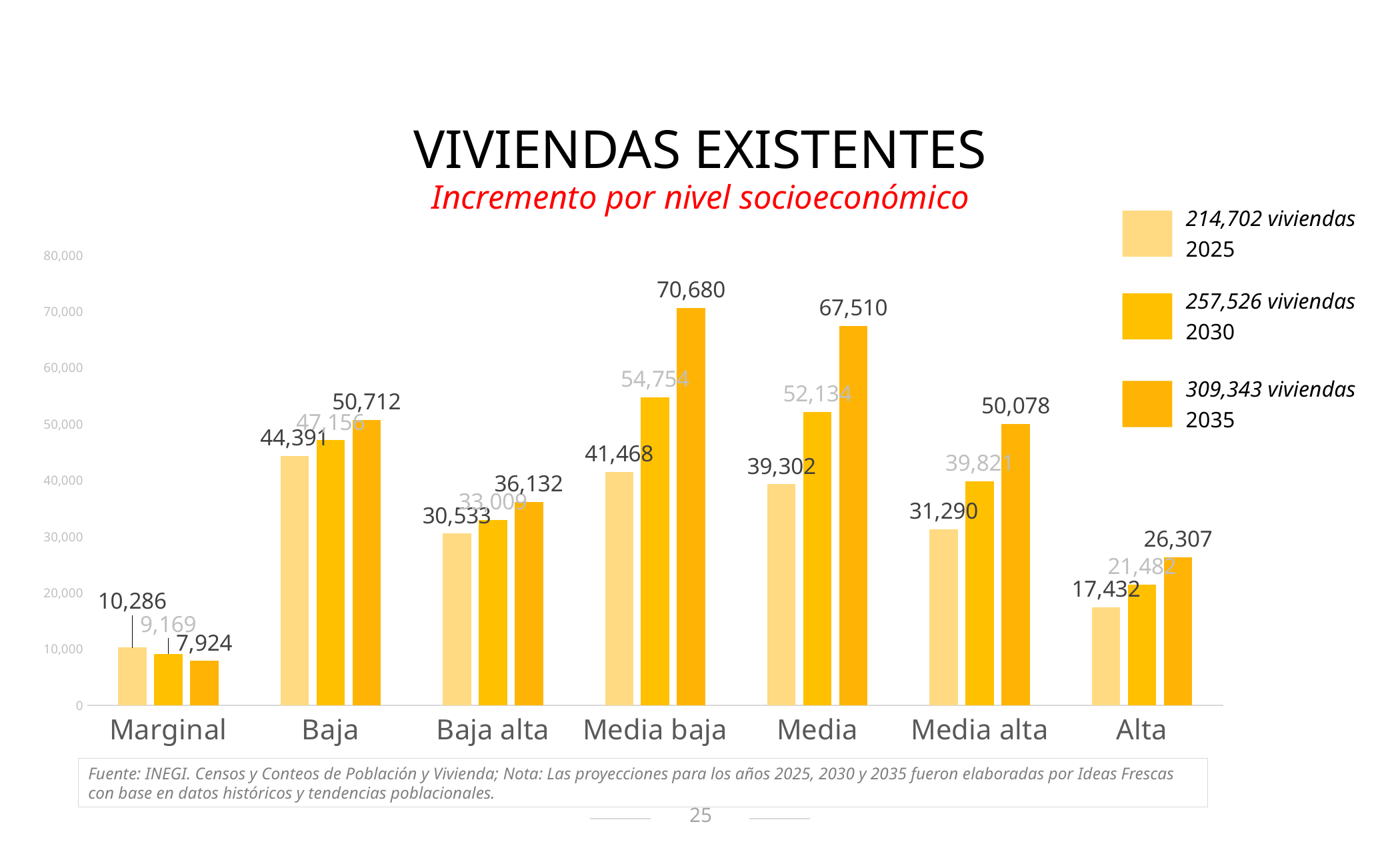
What is the difference between the 2035 and 2025 values for Alta? 8,875 Which is larger, the 2030 value for Baja or the 2030 value for Media? 2030 value for Media How many socioeconomic categories are shown on the x axis? 7 What is the 2025 value for Marginal? 10,286 What is the 2030 value for Media alta? 39,821 What kind of chart is shown on the slide? bar chart What is the 2035 value for Media baja? 70,680 Which category has the lowest 2025 value? Marginal Do the values for Marginal rise or fall from 2025 to 2035? fall How many series does the legend list? 3 Which category has the highest 2035 value? Media baja Is the 2035 value for Media greater or less than 60,000? greater